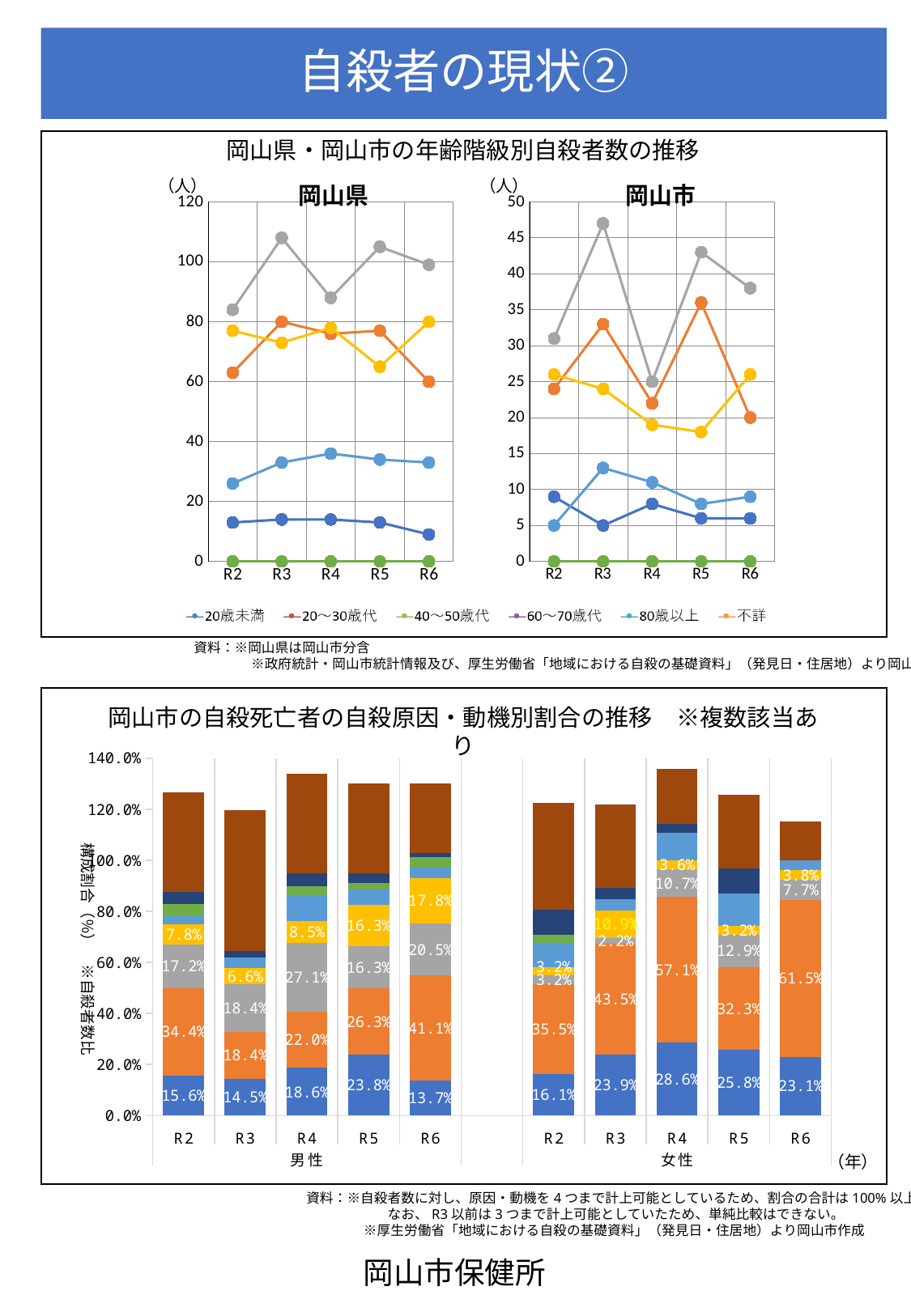
In the 岡山県 line chart, in which year does the highest plotted point occur? R3 How many years are shown on the x axis of the 岡山市 line chart? 5 In the lower stacked bar chart, what is the value of the orange segment for 女性 R6? 61.5% In the lower stacked bar chart, what is the difference between the bottom blue segment for 女性 R4 and the bottom blue segment for 男性 R4? 10.0% In the lower stacked bar chart, what is the value of the bottom blue segment for 男性 R5? 23.8% What kind of chart is the 岡山県 chart in the upper panel? line chart How many series does the legend of the upper panel (岡山県・岡山市の年齢階級別自殺者数の推移) list? 6 What kind of chart is the lower chart (岡山市の自殺死亡者の自殺原因・動機別割合の推移)? bar chart In the 岡山県 line chart, is the highest plotted point greater or less than 100? greater In the 岡山市 line chart, is the highest plotted point greater or less than 45? greater In the lower stacked bar chart, which is larger: the orange segment for 女性 R4 or the orange segment for 男性 R6? 女性 R4 How many stacked bars are there in the lower chart? 10